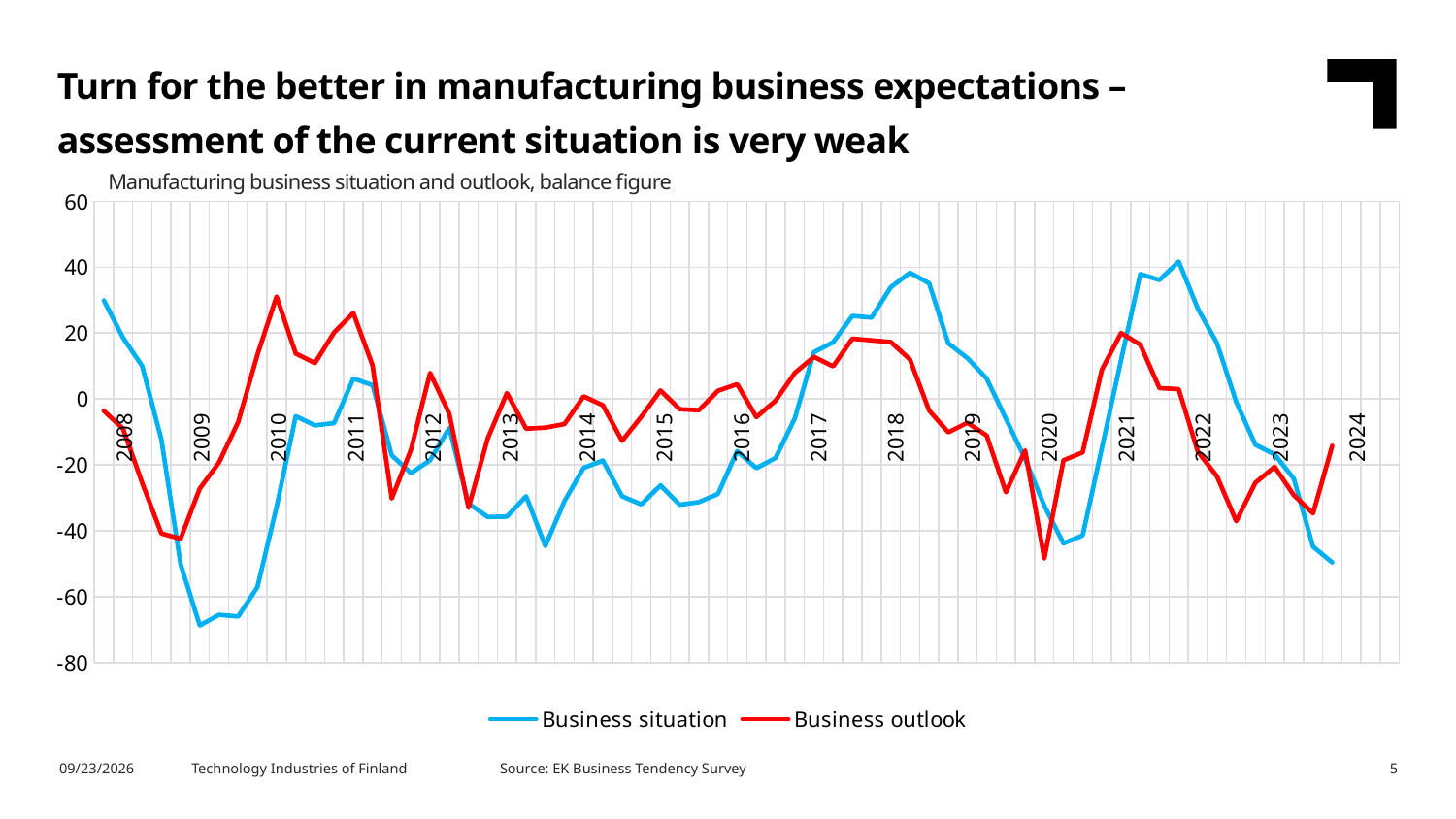
How many year labels are shown on the x axis? 17 How many series does the legend list? 2 What kind of chart is shown on the slide? Line chart Is the peak of the Business outlook line in 2010 greater or less than 20? greater What is the title of the chart? Manufacturing business situation and outlook, balance figure Does the Business situation line rise or fall from its 2021 peak to 2024? Fall Is the lowest value of the Business outlook line in 2020 greater or less than -40? less Which series reaches the lowest value anywhere on the chart? Business situation At the right end of the chart in 2024, which series is higher, Business situation or Business outlook? Business outlook Is the peak of the Business situation line in 2018 greater or less than 20? greater What are the two series named in the legend? Business situation and Business outlook